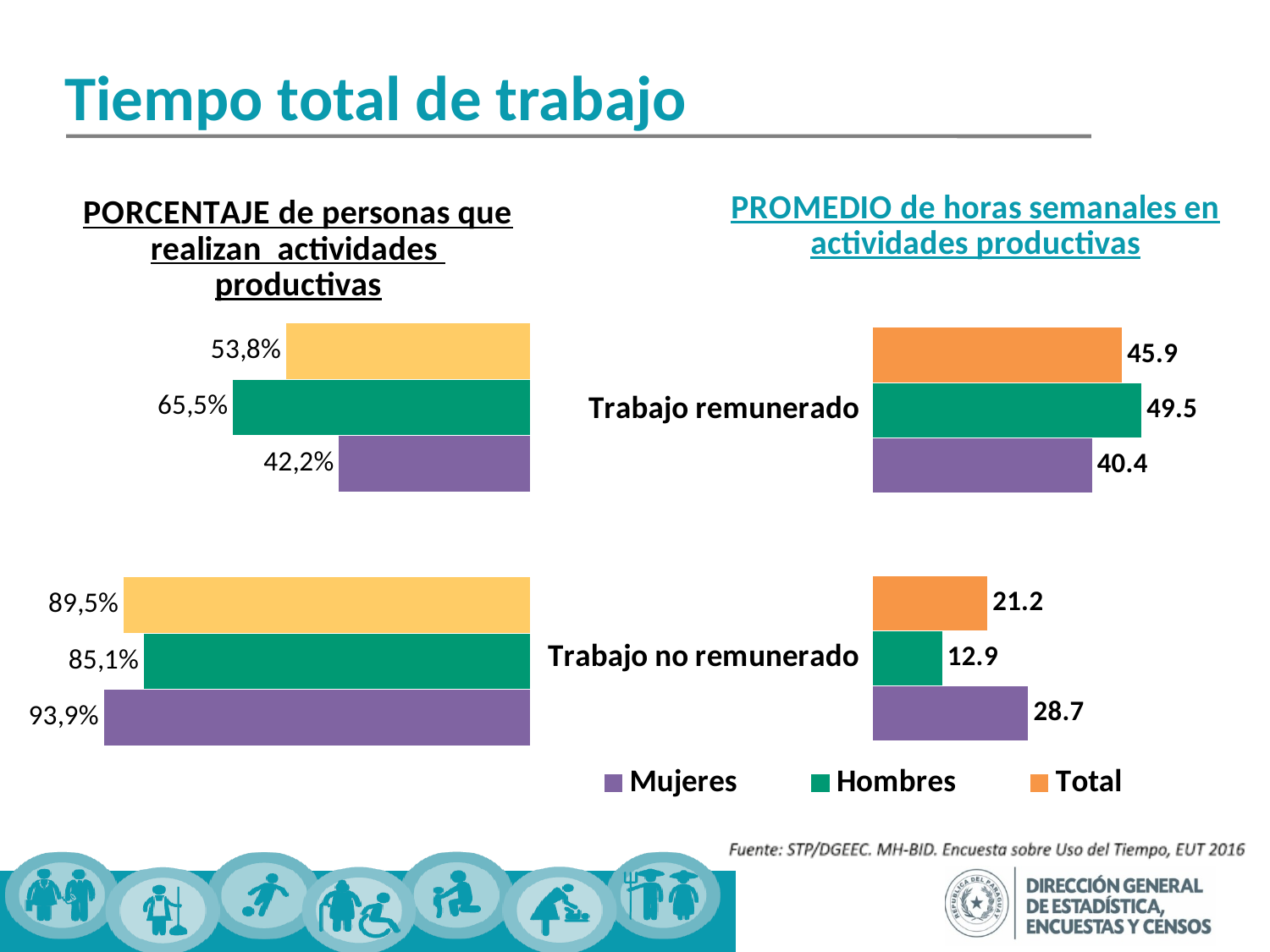
What are the legend entries shown below the chart titled 'PROMEDIO de horas semanales en actividades productivas'? Mujeres, Hombres, Total In the chart titled 'PROMEDIO de horas semanales en actividades productivas', what is the value for Mujeres in Trabajo no remunerado? 28.7 In the chart titled 'PROMEDIO de horas semanales en actividades productivas', which bar has the lowest value? Hombres, Trabajo no remunerado (12.9) In the chart titled 'PROMEDIO de horas semanales en actividades productivas', what is the value for Hombres in Trabajo remunerado? 49.5 In the chart on the left titled 'PORCENTAJE de personas que realizan actividades productivas', what value is shown on the purple bar for Trabajo no remunerado? 93,9% In the chart on the left titled 'PORCENTAJE de personas que realizan actividades productivas', what value is shown on the green bar for Trabajo remunerado? 65,5% In the chart titled 'PROMEDIO de horas semanales en actividades productivas', what is the Total value for Trabajo remunerado? 45.9 What kind of chart is the chart titled 'PROMEDIO de horas semanales en actividades productivas'? Bar chart In the chart titled 'PROMEDIO de horas semanales en actividades productivas', which is larger for Trabajo remunerado, Mujeres or Hombres? Hombres In the chart titled 'PROMEDIO de horas semanales en actividades productivas', what is the difference between Mujeres and Hombres in Trabajo no remunerado? 15.8 How many series does the legend of the chart titled 'PROMEDIO de horas semanales en actividades productivas' list? 3 In the chart on the left titled 'PORCENTAJE de personas que realizan actividades productivas', how many categories (groups of bars) are shown? 2